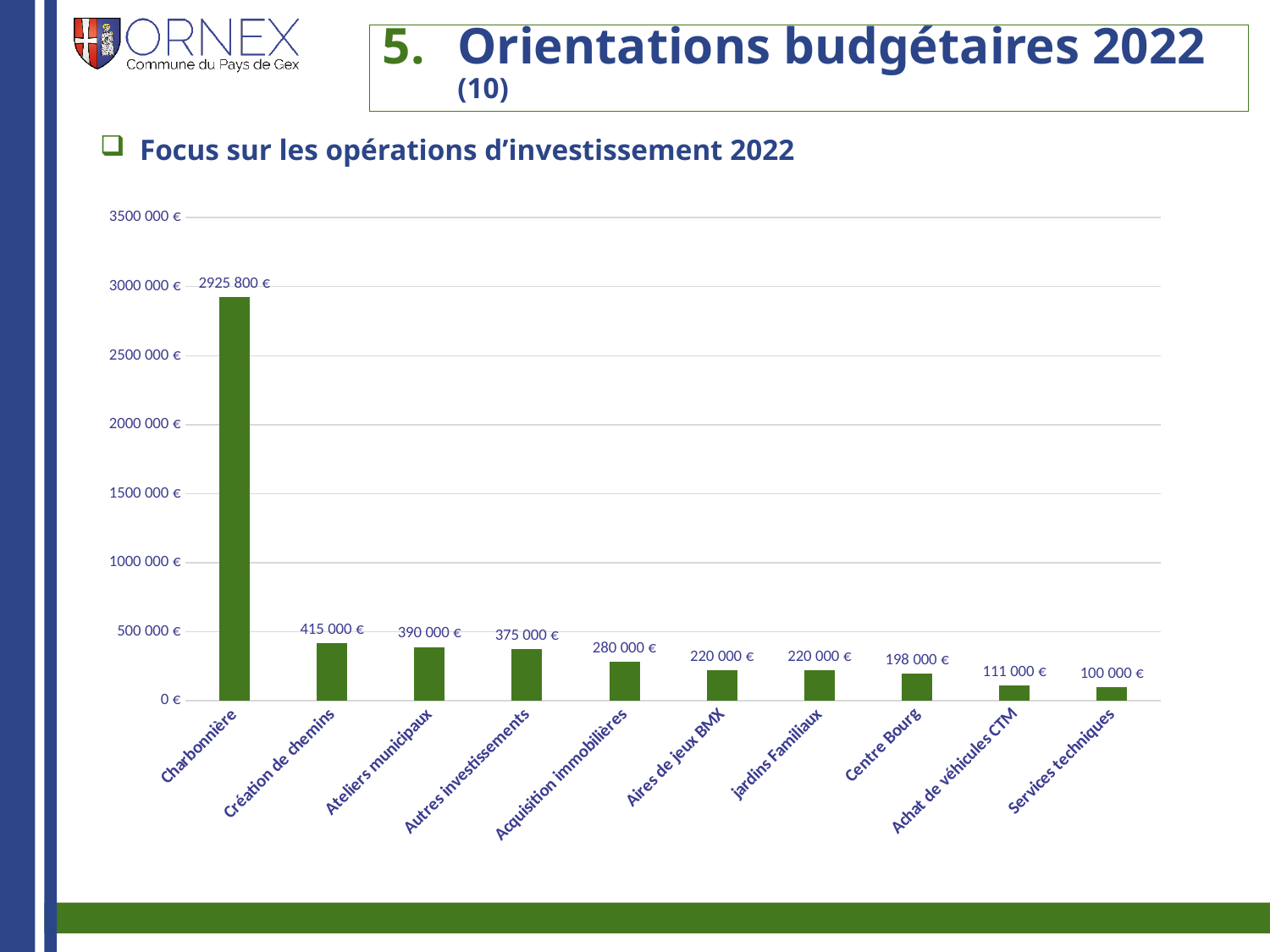
What is the value for Centre Bourg? 198 000 € Do the values rise or fall from left to right along the x axis? fall What is the value for Achat de véhicules CTM? 111 000 € What is the difference between the values for Ateliers municipaux and Autres investissements? 15 000 € What is the value for Création de chemins? 415 000 € Is the value for Charbonnière greater or less than 2500 000 €? greater Which is larger, the value for Acquisition immobilières or the value for Aires de jeux BMX? Acquisition immobilières Which category has the highest value? Charbonnière Which category has the lowest value? Services techniques How many categories are shown on the x axis? 10 What kind of chart is shown on the slide? bar chart What is the value for Charbonnière? 2925 800 €